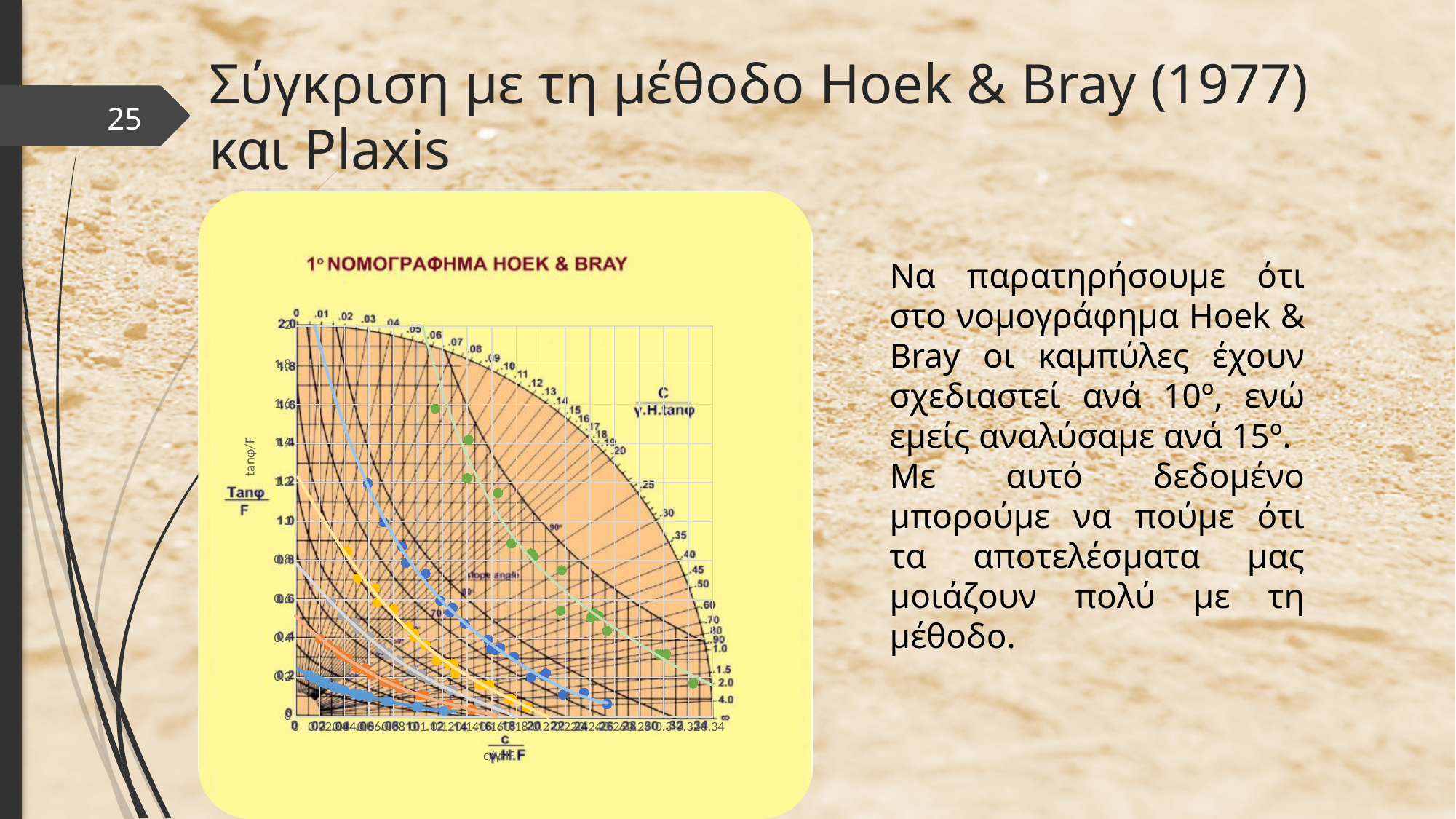
What is the label of the vertical axis of the chart? tanφ/F What is the title of the chart on the slide? 1ο ΝΟΜΟΓΡΑΦΗΜΑ HOEK & BRAY Do the plotted series rise or fall as the value on the x axis increases? fall Is the highest point of the orange series greater or less than 1.0 on the vertical axis? less Which series extends furthest to the right along the x axis, the blue series or the green series? green series Is the rightmost point of the green series greater or less than 0.4 on the vertical axis? less Is the highest point of the green series greater or less than 1.4 on the vertical axis? greater What kind of chart is overlaid on the Hoek & Bray nomogram? scatter chart with smooth lines